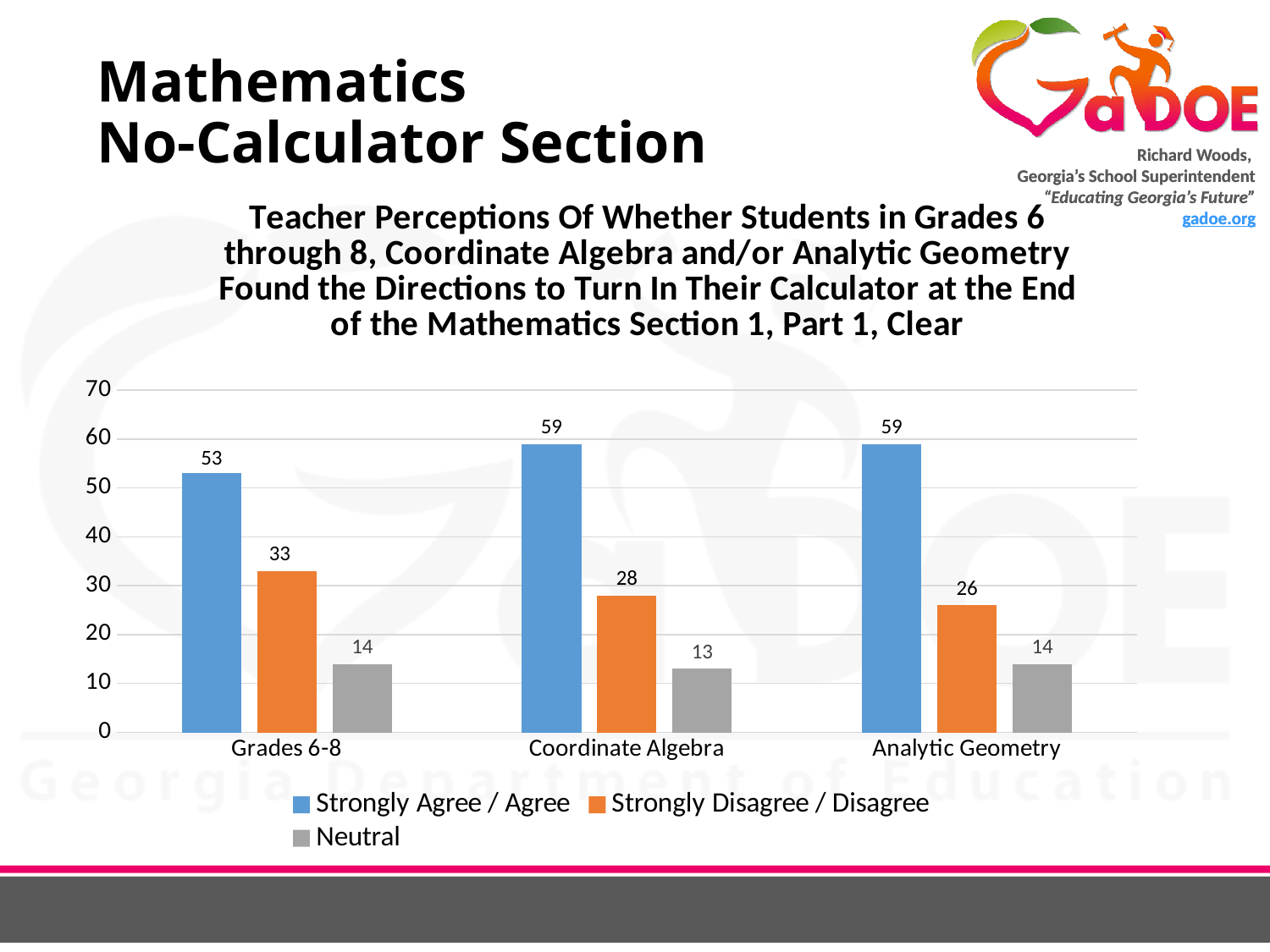
Is the Strongly Agree / Agree value for Analytic Geometry greater or less than 50? greater How many series does the legend list? 3 Which colour represents the Neutral series? gray Which is larger: the Strongly Disagree / Disagree value for Coordinate Algebra or for Analytic Geometry? Coordinate Algebra What is the Strongly Disagree / Disagree value for Coordinate Algebra? 28 Which category has the lowest Strongly Agree / Agree value? Grades 6-8 What is the Strongly Agree / Agree value for Grades 6-8? 53 Which category has the highest Strongly Disagree / Disagree value? Grades 6-8 What kind of chart is shown on the slide? bar chart How many categories are shown on the x axis? 3 What is the Neutral value for Analytic Geometry? 14 What is the difference between the Strongly Agree / Agree values for Coordinate Algebra and Grades 6-8? 6